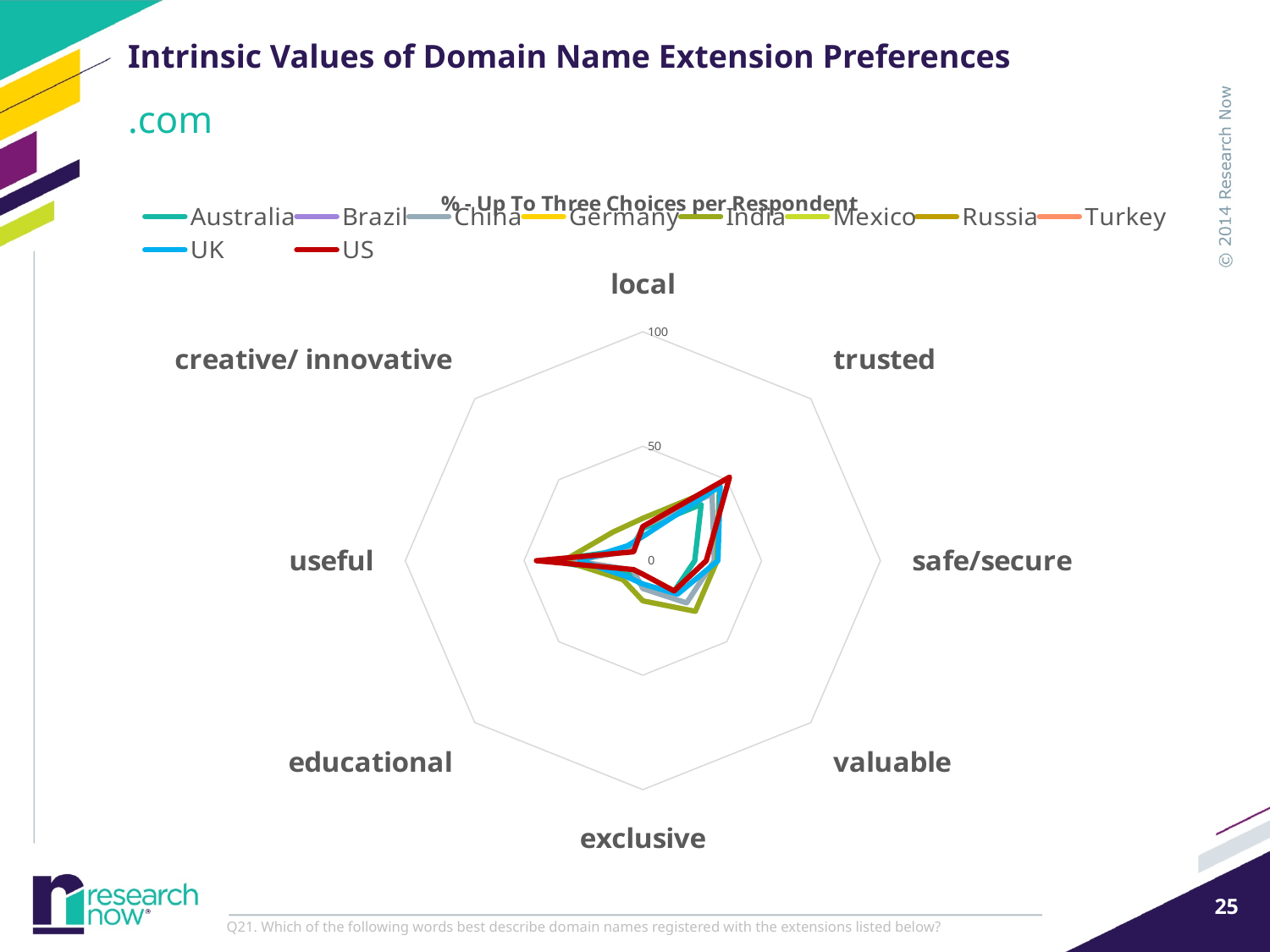
What is the title of the slide? Intrinsic Values of Domain Name Extension Preferences What is the highest value shown on the radar chart's axis scale? 100 Is the value for UK on educational greater or less than 50? less Which domain name extension does this chart describe? .com Is the value for India on exclusive greater or less than 50? less Is the value for US on creative/ innovative greater or less than 50? less What kind of chart is shown on the slide? Radar chart How many categories (axes) does the radar chart have? 8 How many series does the legend list? 10